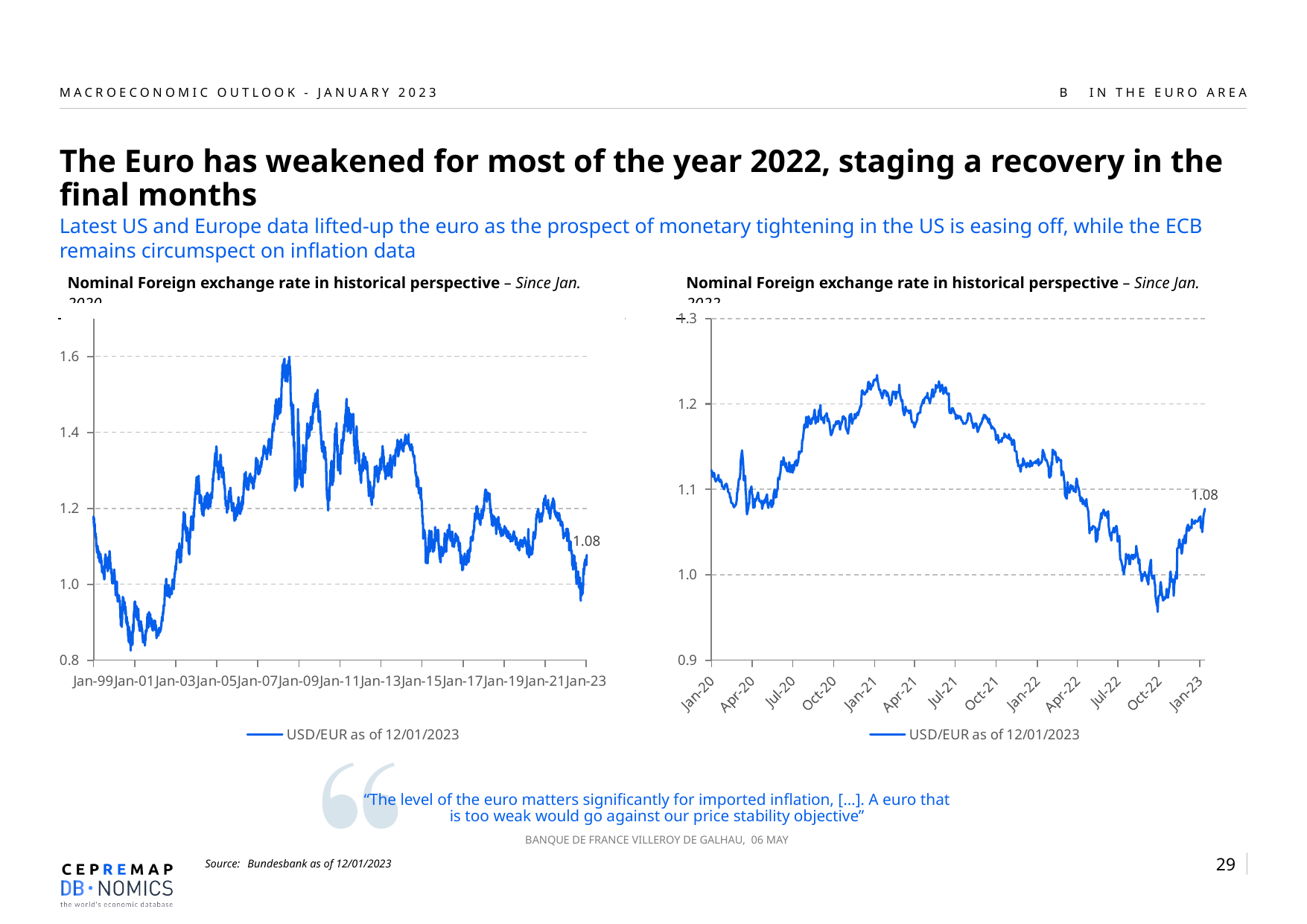
On the right chart, is the peak value around Jan-21 greater or less than 1.2? greater On the left chart (starting Jan-99), what is the latest value labelled at the end of the line? 1.08 On the right chart, is the value around Oct-22 greater or less than 1.0? less On the left chart, is the value around Jan-01 greater or less than 1.0? less How many x-axis labels are shown on the right chart? 13 On the right chart (starting Jan-20), what is the value labelled at the end of the line in Jan-23? 1.08 On the right chart, does the USD/EUR rate rise or fall between Jan-21 and Oct-22? fall How many series does the legend of the right chart list? 1 On the left chart, which is higher: the USD/EUR rate around Jan-08 or around Jan-01? Jan-08 What is the legend entry shown under the left chart? USD/EUR as of 12/01/2023 What kind of chart is the left chart, 'Nominal Foreign exchange rate in historical perspective'? line chart